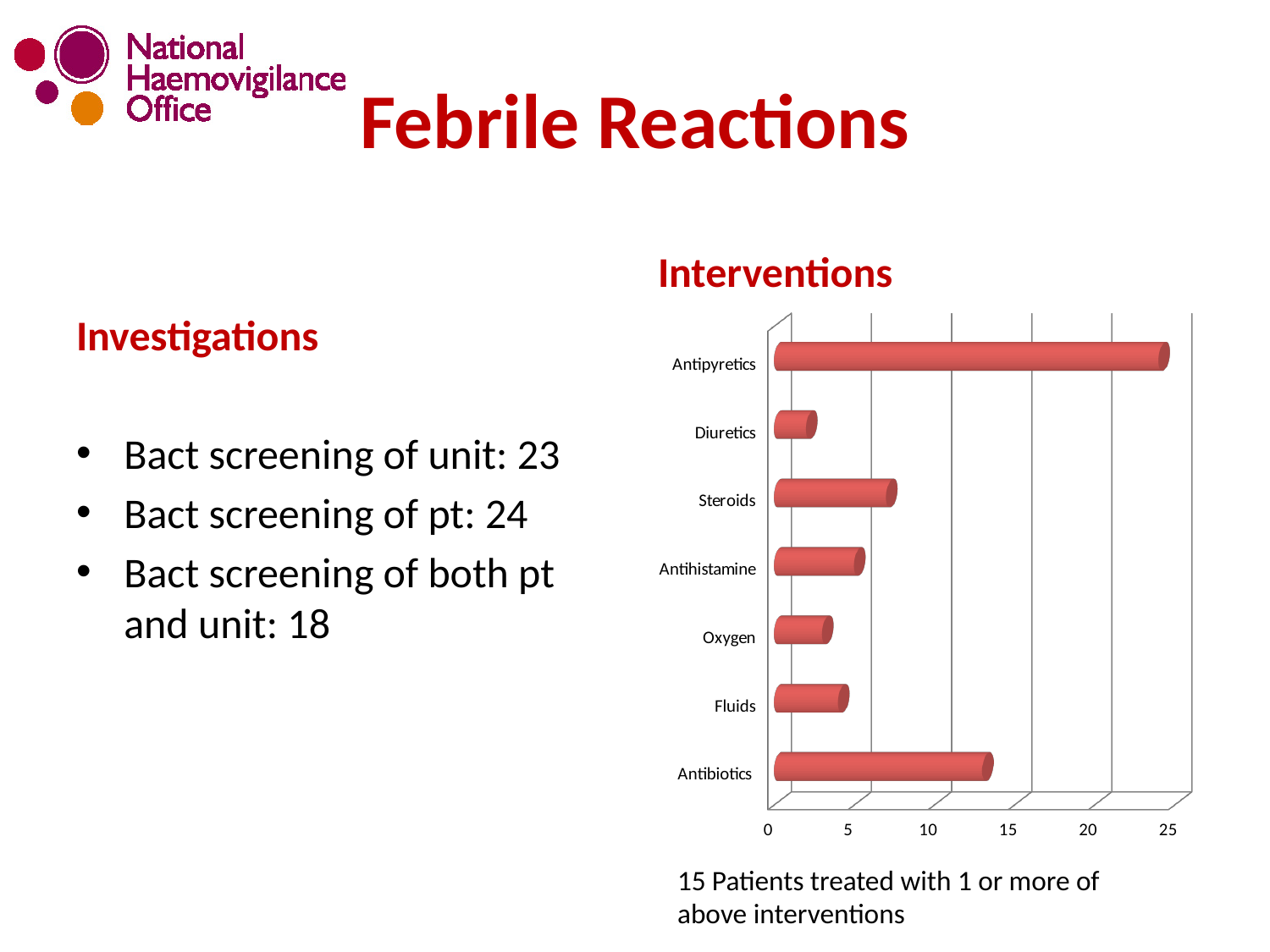
In the Interventions chart, is the value for Oxygen greater or less than 5? less In the Interventions chart, is the value for Steroids greater or less than 5? greater In the Interventions chart, which is larger, the value for Antipyretics or the value for Antibiotics? Antipyretics In the Interventions chart, which is larger, the value for Antibiotics or the value for Steroids? Antibiotics What is the highest value shown on the horizontal axis of the Interventions chart? 25 What kind of chart is shown under the heading "Interventions"? bar chart In the Interventions chart, is the value for Diuretics greater or less than 5? less What is the title of the chart on the slide? Interventions How many intervention categories are plotted in the Interventions chart? 7 In the Interventions chart, which intervention has the highest value? Antipyretics